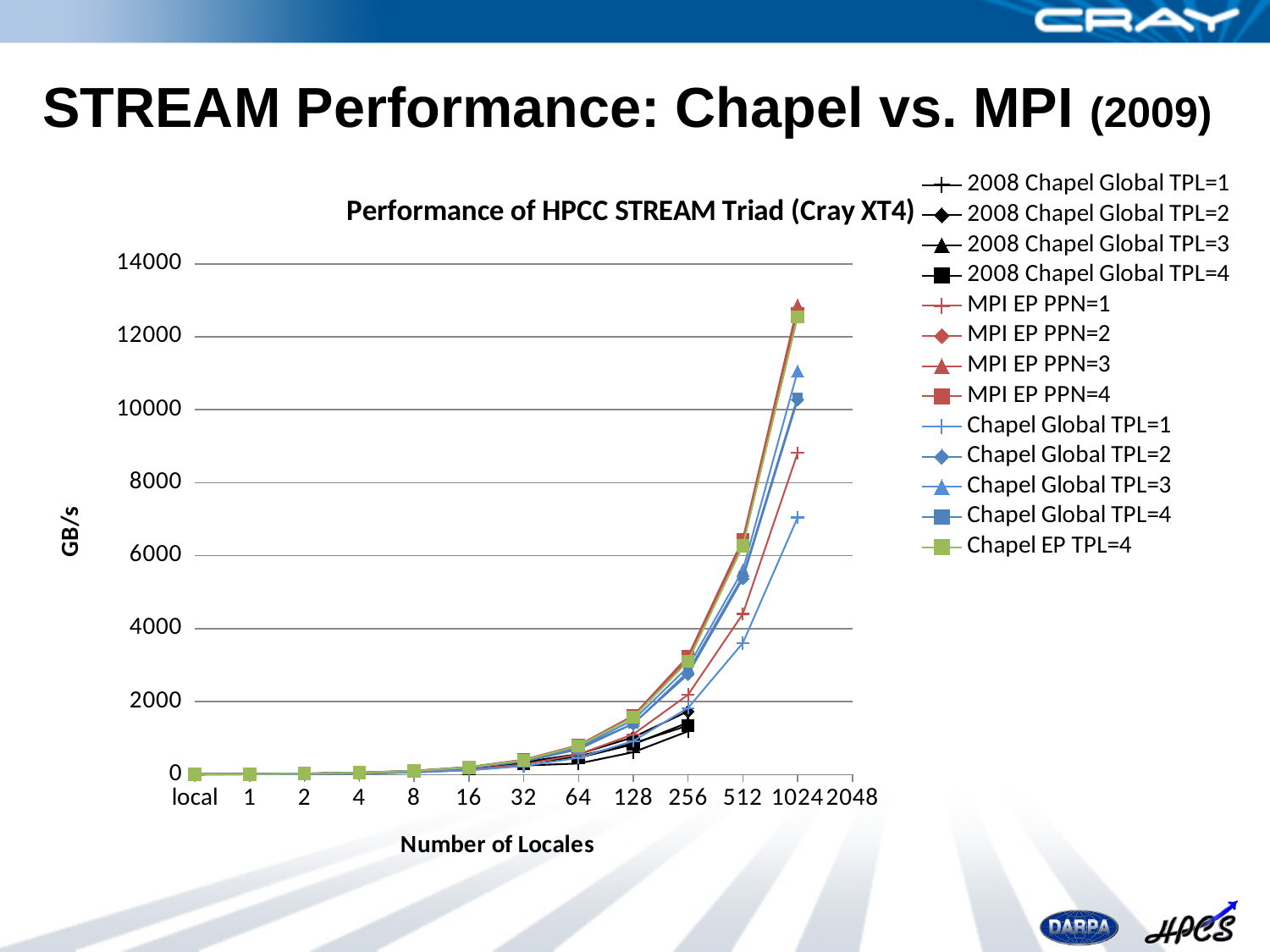
Is the value for MPI EP PPN=3 at 1024 locales greater or less than 12000? greater Is the value for MPI EP PPN=1 at 1024 locales greater or less than 8000? greater How many categories are shown on the x axis (Number of Locales)? 13 What is the title of the chart? Performance of HPCC STREAM Triad (Cray XT4) Do the values for MPI EP PPN=4 rise or fall as the number of locales increases? rise Which series has the lowest value at 1024 locales? Chapel Global TPL=1 Is the value for 2008 Chapel Global TPL=4 at 256 locales greater or less than 2000? less What is the label of the y axis? GB/s At 1024 locales, which is larger: MPI EP PPN=1 or Chapel Global TPL=1? MPI EP PPN=1 How many series does the legend list? 13 What kind of chart is shown on the slide? line chart